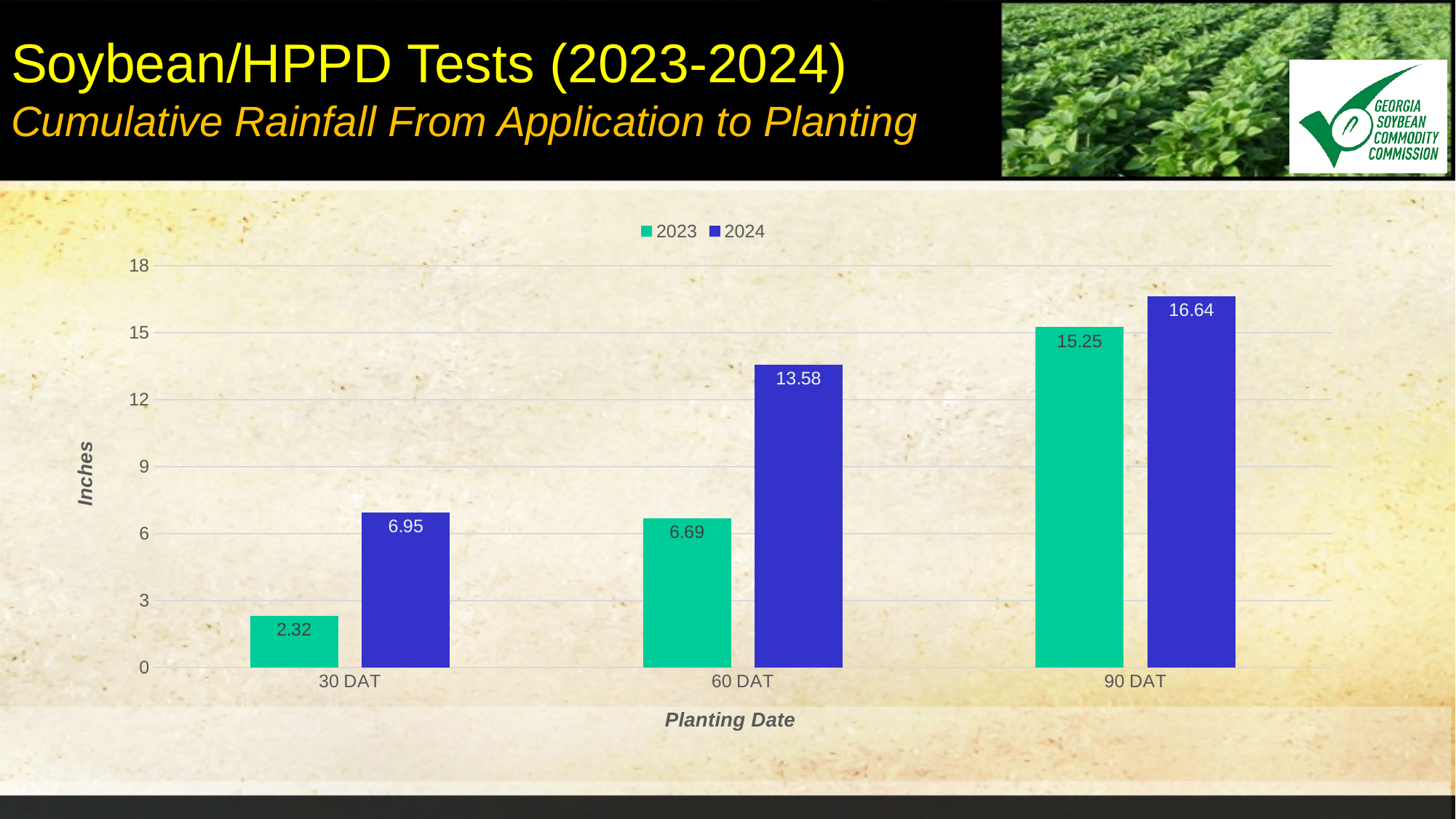
What is the cumulative rainfall for 2023 at 90 DAT? 15.25 Which planting date has the lowest 2023 value? 30 DAT Do the 2023 values rise or fall from 30 DAT to 90 DAT? rise What is the cumulative rainfall for 2024 at 60 DAT? 13.58 What kind of chart is shown on the slide? bar chart What is the cumulative rainfall for 2023 at 30 DAT? 2.32 What is the difference between the 2024 and 2023 values at 30 DAT? 4.63 How many planting date categories are shown on the x axis? 3 Which is larger at 60 DAT, the 2023 value or the 2024 value? 2024 Which planting date has the highest 2024 value? 90 DAT What is the difference between the 2024 and 2023 values at 90 DAT? 1.39 How many series does the legend list? 2